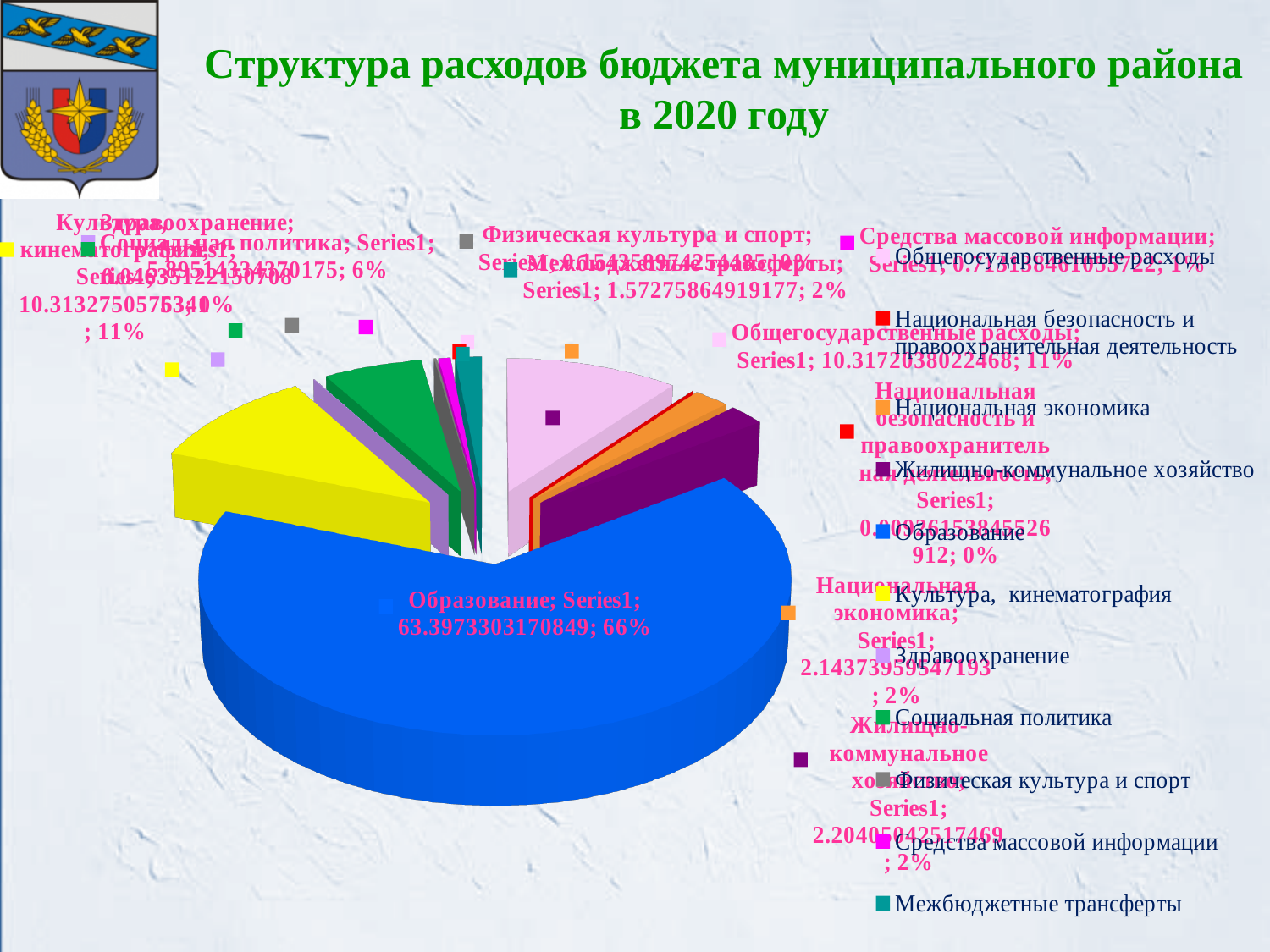
By how many percentage points does the share of Образование exceed the share of Социальная политика? 60 What percentage share is shown for Социальная политика? 6% What percentage share is shown for Средства массовой информации? 1% What percentage share is shown for Общегосударственные расходы? 11% What is the title of the chart? Структура расходов бюджета муниципального района в 2020 году How many categories does the legend list? 11 Which category has the largest share of the pie? Образование What kind of chart is shown on the slide? pie chart Which has a larger share, Образование or Социальная политика? Образование